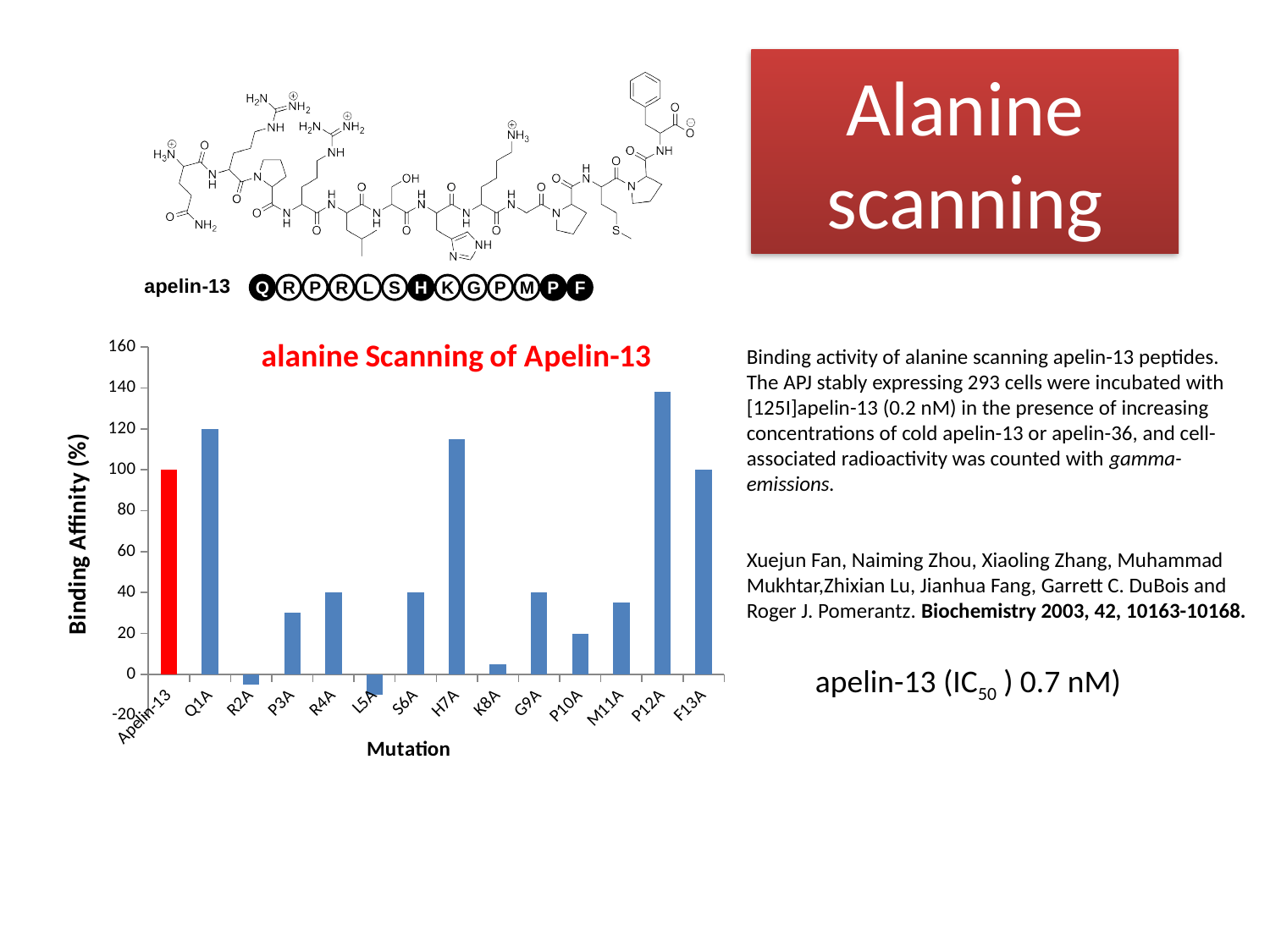
What is the binding affinity (%) for Apelin-13 in the chart? 100 What is the title of the chart? alanine Scanning of Apelin-13 Which has a larger binding affinity, K8A or M11A? M11A How many mutation categories are plotted on the x axis of the chart? 14 Is the value for P3A greater or less than 40? less Which mutation has the highest binding affinity in the chart? P12A Is the value for H7A greater or less than 100? greater Which mutation has the lowest binding affinity in the chart? L5A What is the label of the y axis of the chart? Binding Affinity (%) What kind of chart is shown on the slide? bar chart Which has a larger binding affinity, P12A or H7A? P12A What is the binding affinity (%) for Q1A in the chart? 120